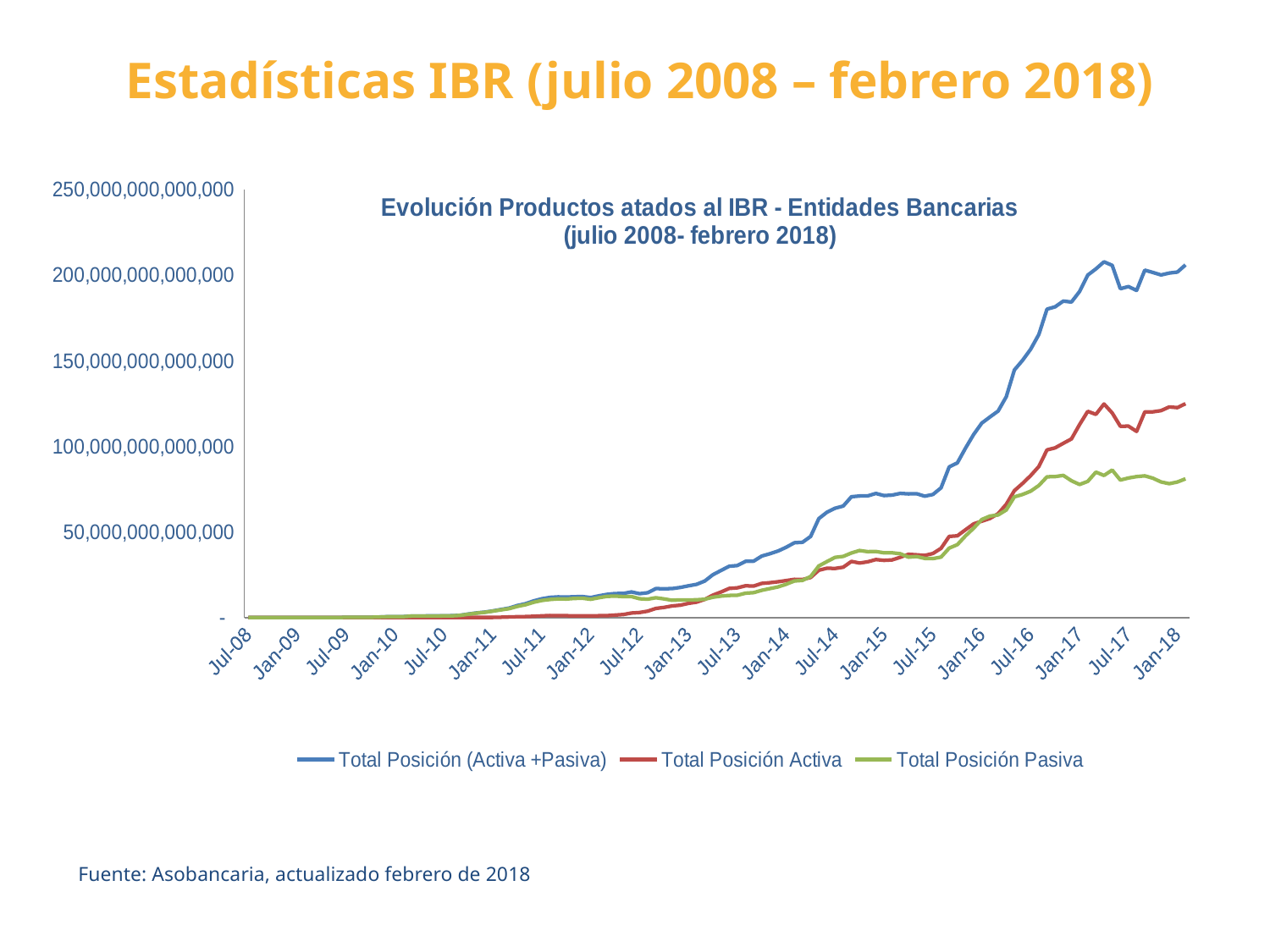
How many series does the legend list? 3 What is the title of the chart? Evolución Productos atados al IBR - Entidades Bancarias (julio 2008- febrero 2018) Overall, does the Total Posición (Activa +Pasiva) series rise or fall from Jul-08 to Jan-18? Rise Is the value of Total Posición Pasiva at Jan-18 greater or less than 100,000,000,000,000? less Is the value of Total Posición (Activa +Pasiva) at Jan-17 greater or less than 150,000,000,000,000? greater What kind of chart is shown on the slide? Line chart Which series has the highest value at Jan-18? Total Posición (Activa +Pasiva) Is the value of Total Posición (Activa +Pasiva) at Jan-15 greater or less than 100,000,000,000,000? less How many date labels are shown on the x axis? 20 At Jan-18, which is larger: Total Posición Activa or Total Posición Pasiva? Total Posición Activa Which series is drawn in green? Total Posición Pasiva